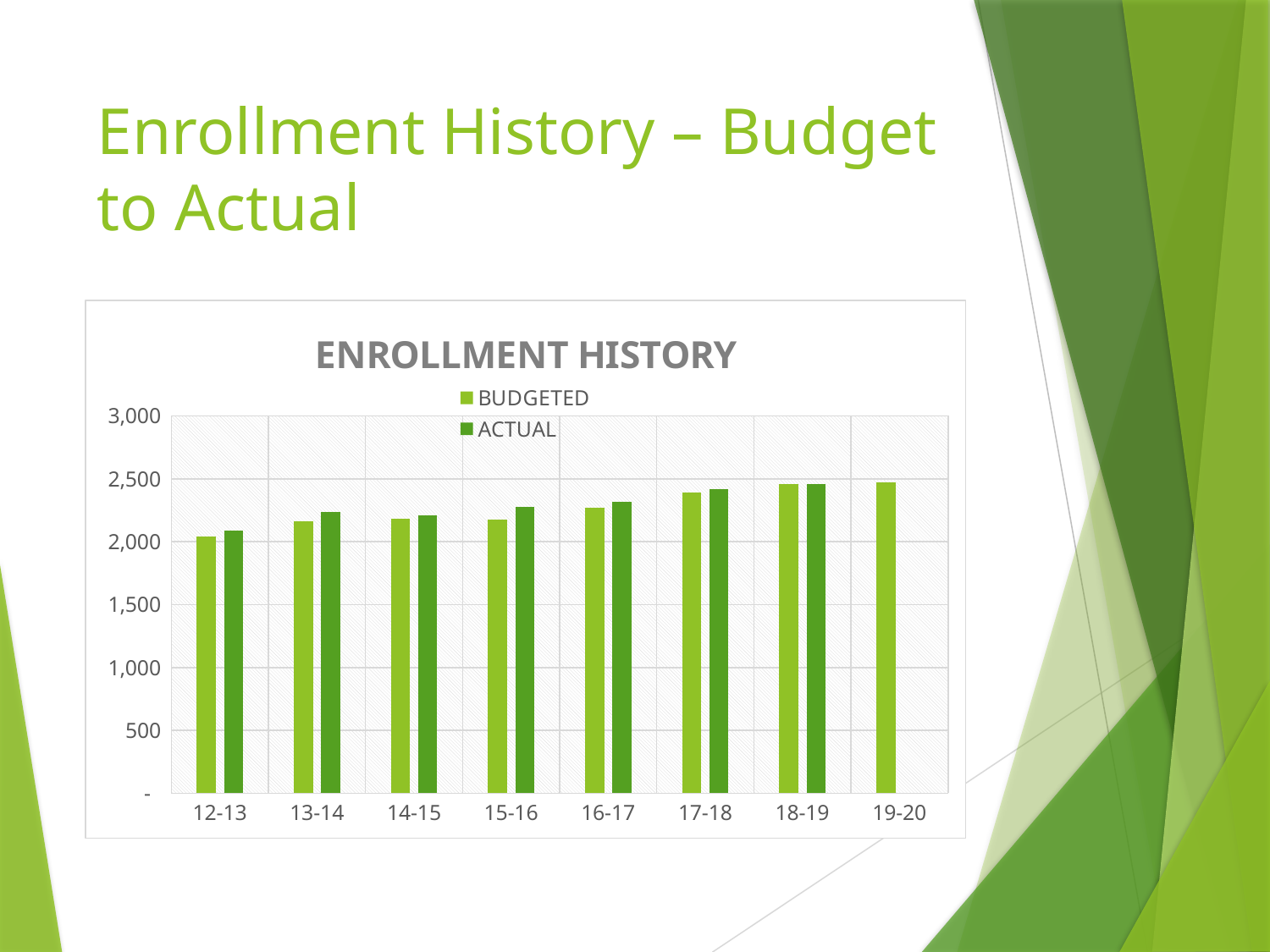
How many series does the legend list? 2 Do the BUDGETED values generally rise or fall from 12-13 to 19-20? rise Which series are listed in the legend? BUDGETED and ACTUAL Is the ACTUAL value for 17-18 greater or less than 2,500? less Which school year has the lowest BUDGETED value? 12-13 What is the title of the chart? ENROLLMENT HISTORY What kind of chart is shown on the slide? bar chart Is the BUDGETED value for 12-13 greater or less than 2,000? greater How many school years are shown on the x axis? 8 Which school year has the lowest ACTUAL value? 12-13 For 13-14, which is larger, the BUDGETED or the ACTUAL value? ACTUAL